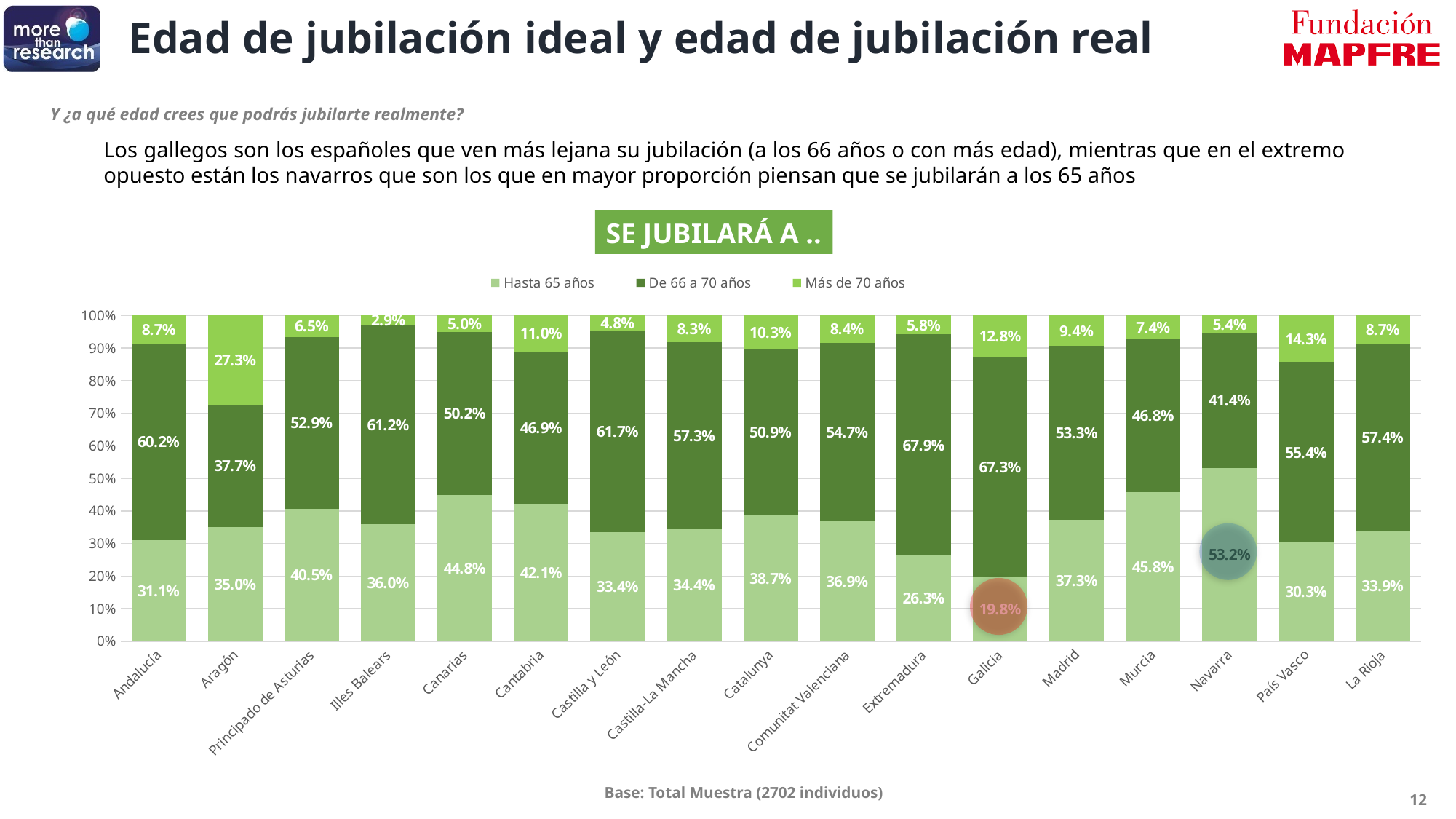
What is the value for 'De 66 a 70 años' in Extremadura? 67.9% What is the value for 'Más de 70 años' in Aragón? 27.3% Which region has the lowest value for 'Hasta 65 años'? Galicia Which is larger: the 'Hasta 65 años' value for Canarias or for Cantabria? Canarias How many series does the legend list? 3 How many regions are shown on the x axis of the chart? 17 What kind of chart is shown on the slide? Stacked bar chart What is the difference between the 'Hasta 65 años' values for Navarra and Galicia? 33.4 percentage points Which region has the lowest value for 'Más de 70 años'? Illes Balears Which region has the highest value for 'Más de 70 años'? Aragón What percentage of respondents in Galicia say they will retire at 65 or earlier (Hasta 65 años)? 19.8% Which region has the highest value for 'Hasta 65 años'? Navarra